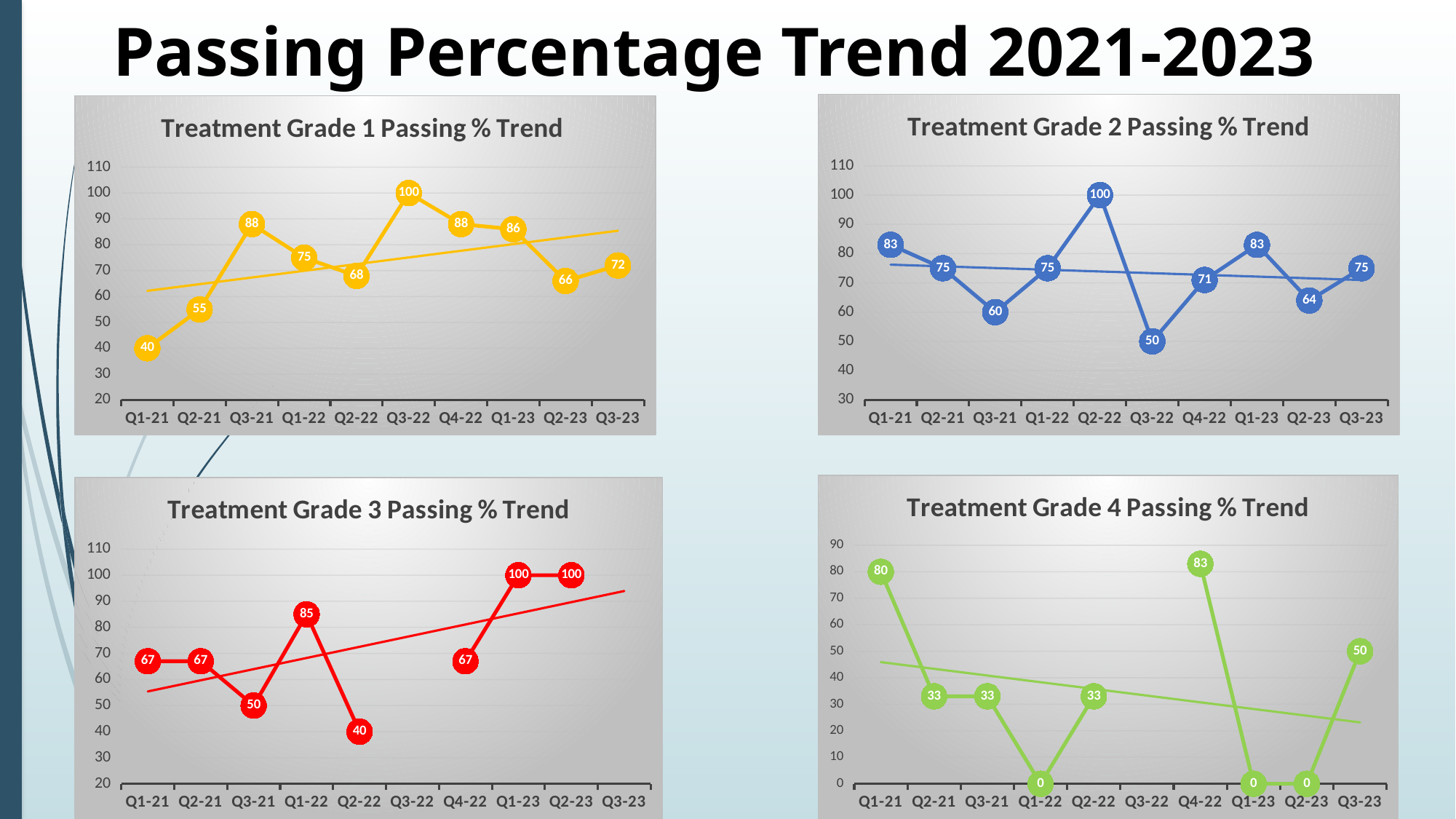
What kind of chart is the Treatment Grade 4 Passing % Trend chart? Line chart In the Treatment Grade 2 Passing % Trend chart, which quarter has the highest value? Q2-22 In the Treatment Grade 4 Passing % Trend chart, what is the difference between the Q1-21 value and the Q3-23 value? 30 In the Treatment Grade 2 Passing % Trend chart, which is larger, the value for Q1-21 or the value for Q2-23? Q1-21 In the Treatment Grade 3 Passing % Trend chart, which quarter has the lowest value? Q2-22 In the Treatment Grade 1 Passing % Trend chart, what is the difference between the Q3-22 value and the Q1-21 value? 60 In the Treatment Grade 1 Passing % Trend chart, what is the value for Q3-21? 88 In the Treatment Grade 2 Passing % Trend chart, what is the value for Q3-22? 50 In the Treatment Grade 1 Passing % Trend chart, which quarter has the lowest value? Q1-21 How many quarters are shown on the x axis of the Treatment Grade 1 Passing % Trend chart? 10 In the Treatment Grade 3 Passing % Trend chart, what is the value for Q1-22? 85 In the Treatment Grade 4 Passing % Trend chart, what is the value for Q4-22? 83